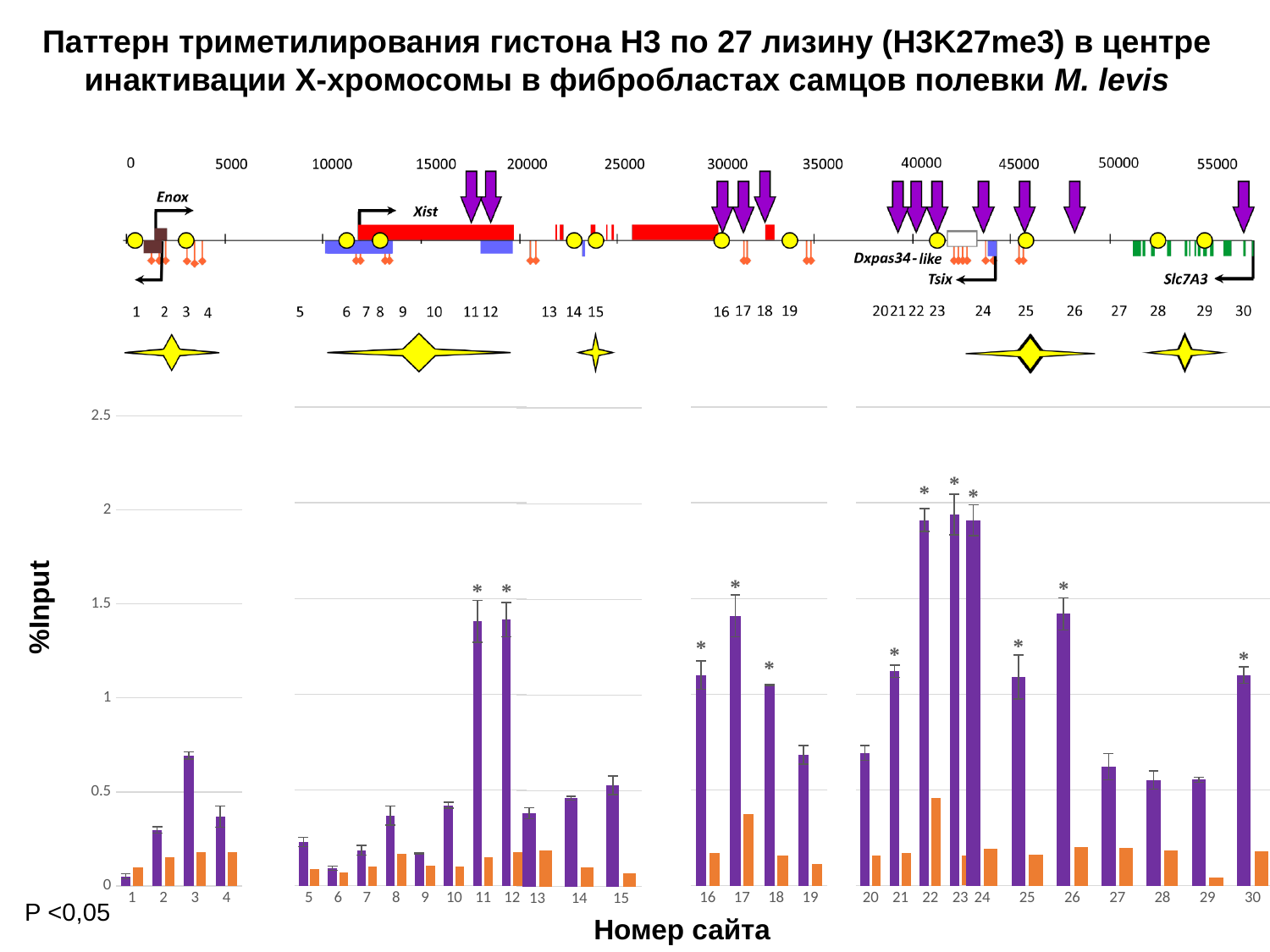
How many sites (categories) are plotted along the x axis of the bar chart? 30 Is the purple bar for site 1 greater or less than 0.5? less Is the purple bar for site 3 greater or less than 0.5? greater Which has the taller purple bar, site 22 or site 16? site 22 Is the purple bar for site 22 greater or less than 1.5? greater Which site has the lowest purple bar in the chart? site 1 What is the title of the y axis of the bar chart? %Input What is the title of the x axis of the bar chart? Номер сайта What kind of chart is shown below the gene map on the slide? bar chart Do the purple bars rise or fall from site 20 to site 23? rise Which has the taller orange bar, site 17 or site 16? site 17